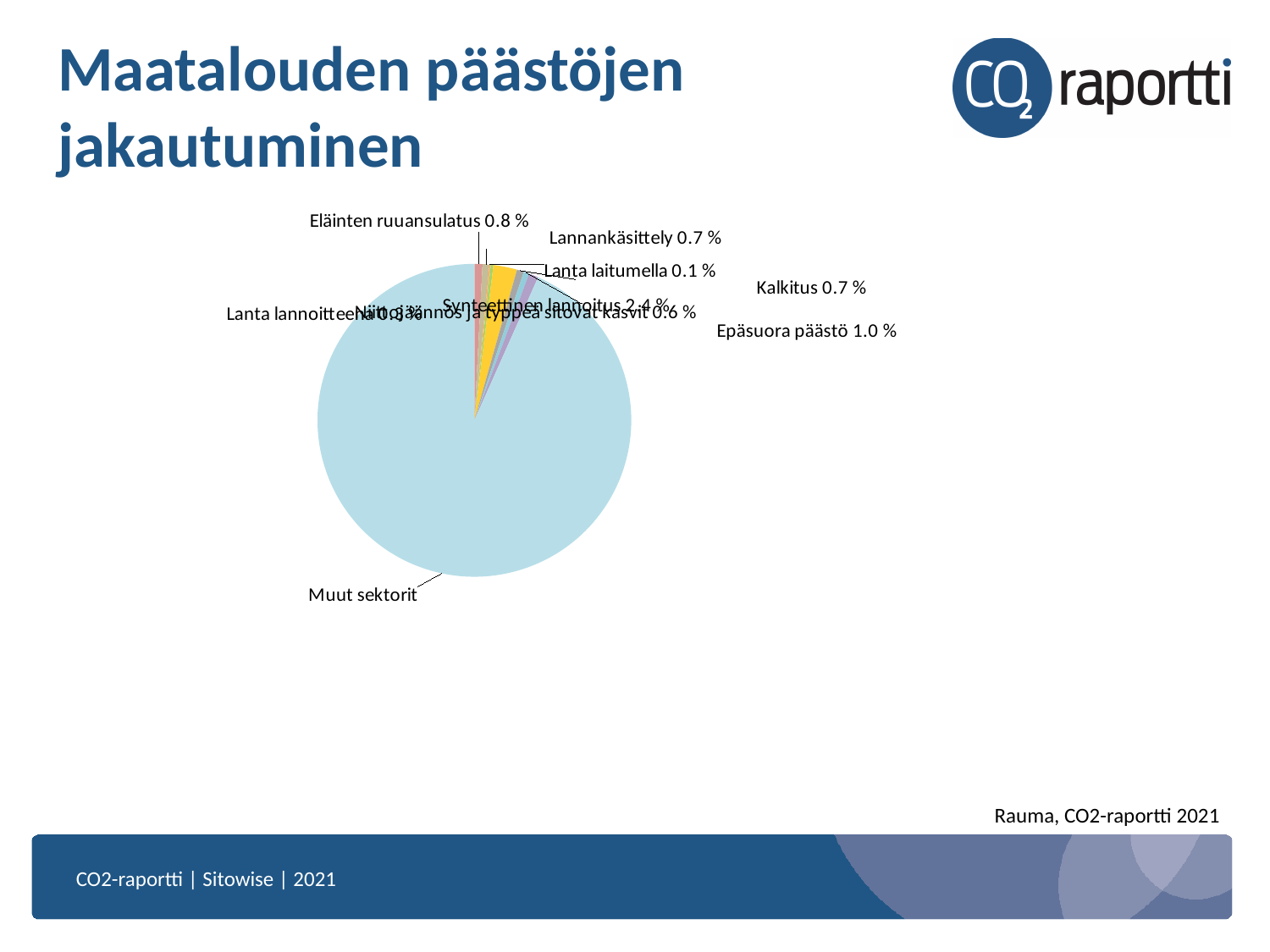
What share of the pie does Synteettinen lannoitus have? 2.4 % Which has the larger share, Synteettinen lannoitus or Epäsuora päästö? Synteettinen lannoitus What share is shown for Lanta laitumella? 0.1 % What kind of chart is shown on the slide? pie chart Which has the larger share, Eläinten ruuansulatus or Lanta laitumella? Eläinten ruuansulatus What share is shown for Epäsuora päästö? 1.0 % What share is shown for Kalkitus? 0.7 % Which slice of the pie is the largest? Muut sektorit What share is shown for Eläinten ruuansulatus? 0.8 % What share is shown for Lannankäsittely? 0.7 % How much larger is the share of Synteettinen lannoitus than that of Eläinten ruuansulatus? 1.6 % What is the title of the slide containing the pie chart? Maatalouden päästöjen jakautuminen